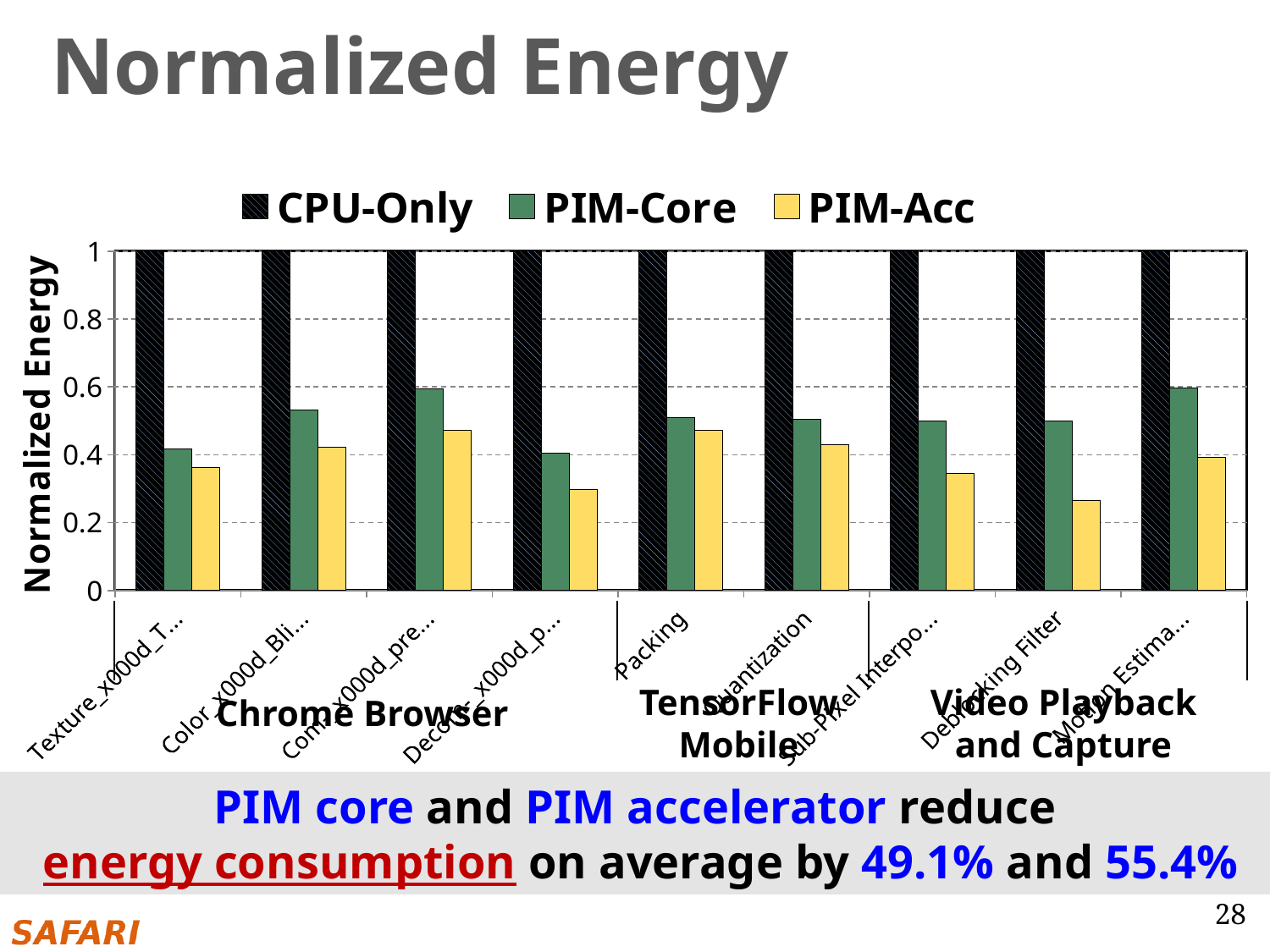
Is the PIM-Acc value for Quantization greater or less than 0.6? less What is the CPU-Only value for Deblocking Filter? 1 What kind of chart is shown on the slide? bar chart How many series does the legend list? 3 How many categories (groups of bars) are plotted along the x axis? 9 What is the label of the y axis? Normalized Energy Which series is shown with yellow bars? PIM-Acc What is the CPU-Only value for Packing? 1 Is the PIM-Acc value for Deblocking Filter greater or less than 0.4? less Is the PIM-Core value for Packing greater or less than 0.4? greater For Deblocking Filter, which series has the lowest value? PIM-Acc For Deblocking Filter, which is larger: the PIM-Core value or the PIM-Acc value? PIM-Core